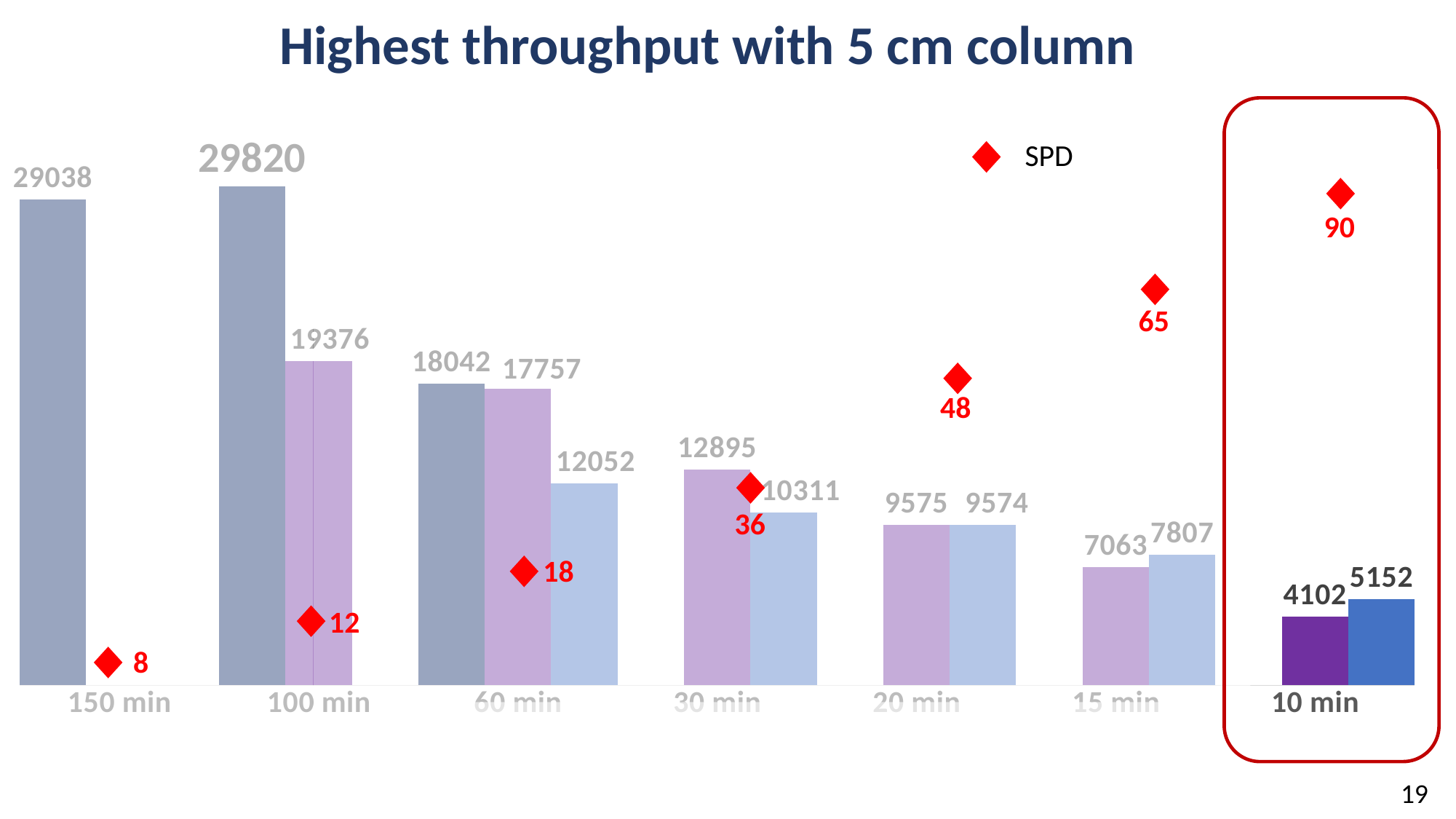
Do the SPD values rise or fall moving from 150 min to 10 min along the x axis? rise Which is larger: the tallest bar at 100 min (29820) or the tallest bar at 150 min (29038)? 29820 at 100 min Which category has the lowest SPD value? 150 min Which category has the highest SPD value? 10 min What is the SPD value for 60 min? 18 What kind of chart is shown on the slide? bar chart What is the difference between the two bar values shown for 10 min (5152 and 4102)? 1050 What is the title of the slide? Highest throughput with 5 cm column What is the SPD value for 10 min? 90 What is the only series name listed in the legend? SPD What is the difference between the SPD values for 10 min and 15 min? 25 How many time categories are shown on the x axis? 7